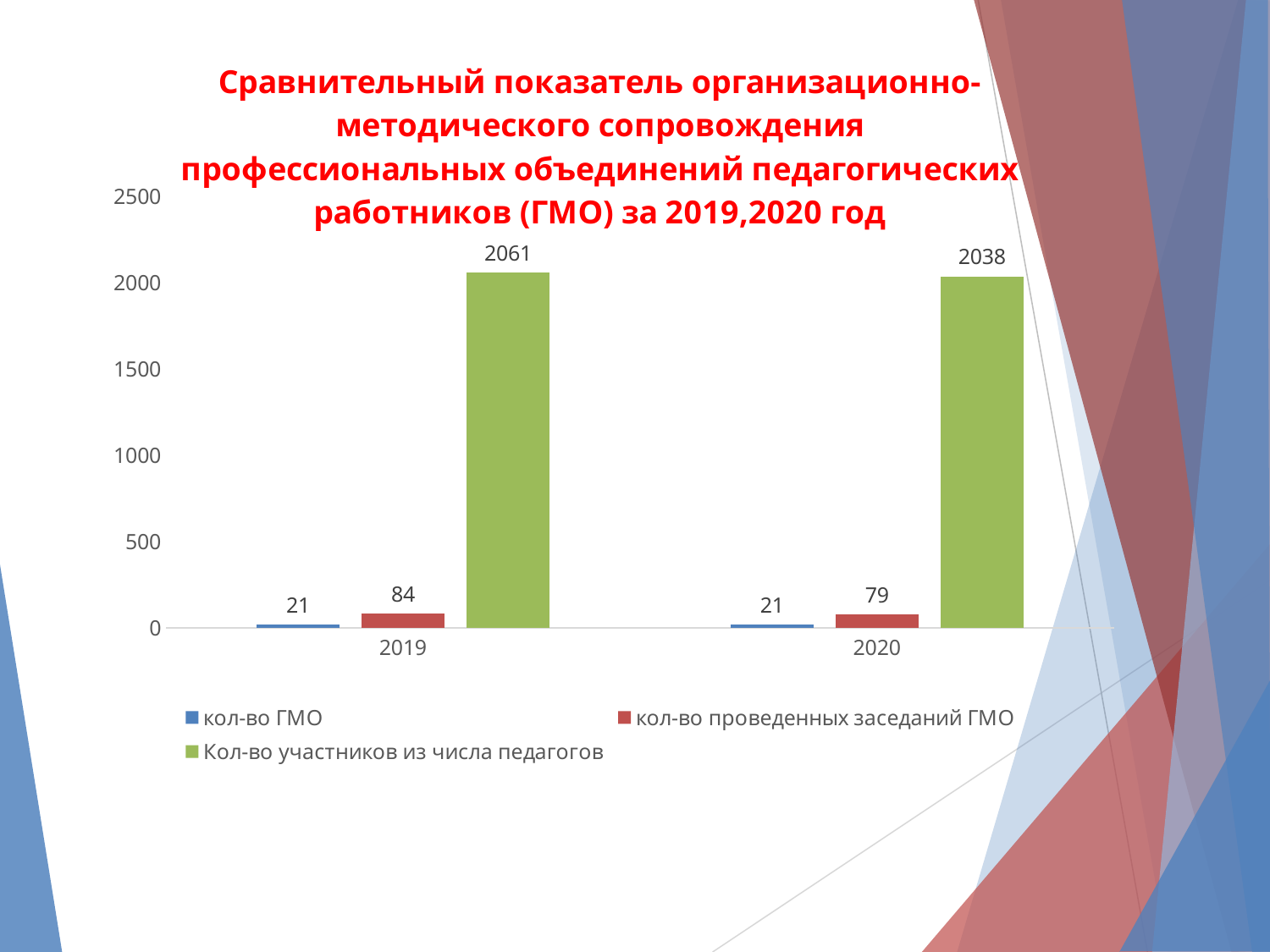
How many year categories are shown on the x axis? 2 What is the value of 'Кол-во участников из числа педагогов' for 2020? 2038 What is the difference in 'кол-во проведенных заседаний ГМО' between 2019 and 2020? 5 Does the value for 'Кол-во участников из числа педагогов' rise or fall from 2019 to 2020? Fall Which year has the higher value for 'кол-во проведенных заседаний ГМО', 2019 or 2020? 2019 What is the value of 'кол-во ГМО' for 2020? 21 What type of chart is shown on the slide? Bar chart Which series is shown in green in the legend? Кол-во участников из числа педагогов How many series does the legend list? 3 What is the difference between the number of participants in 2019 and in 2020? 23 What is the value of 'кол-во проведенных заседаний ГМО' for 2019? 84 What is the value of 'Кол-во участников из числа педагогов' for 2019? 2061